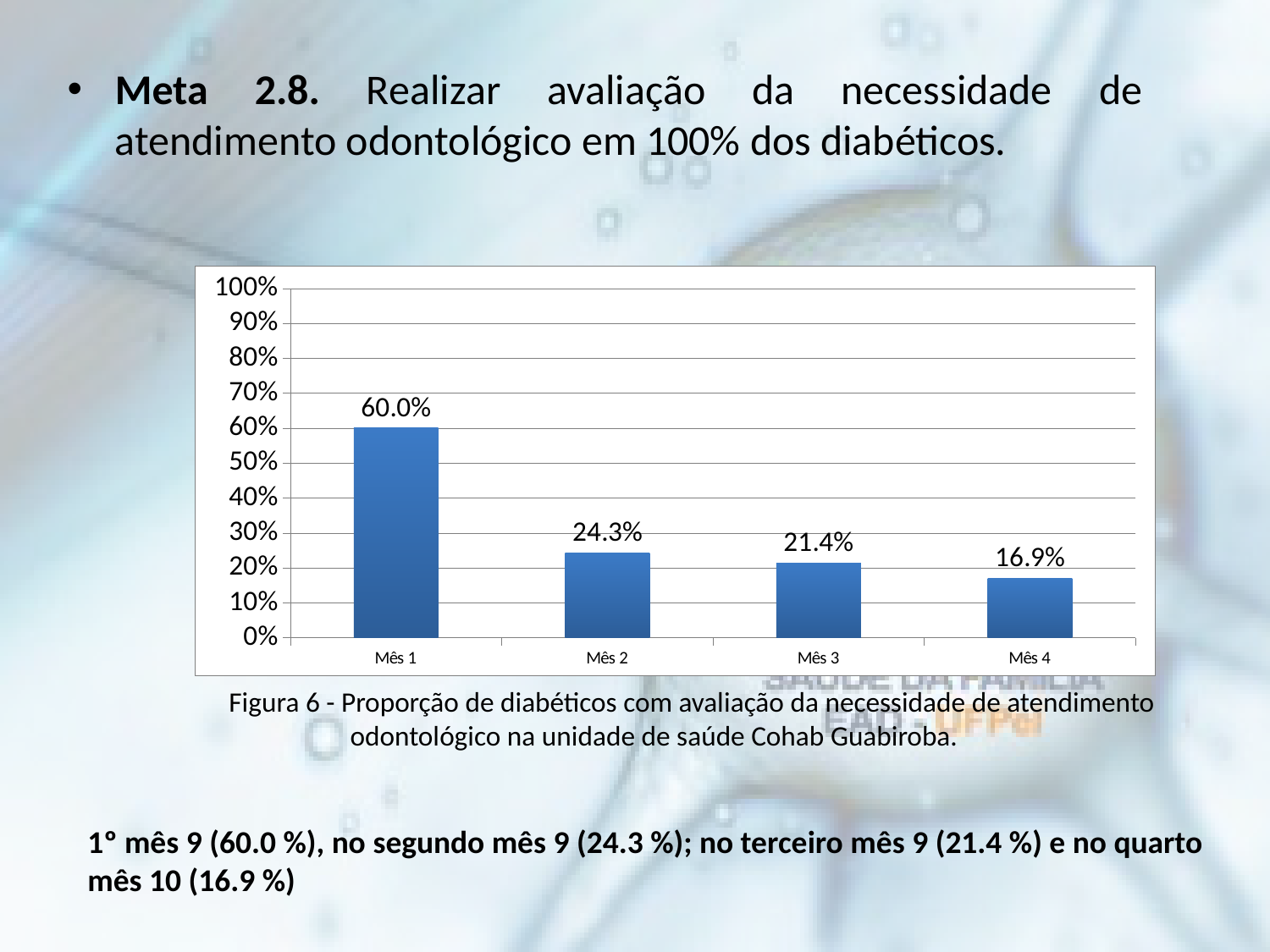
How many months are shown on the x axis? 4 Which is larger, the value for Mês 2 or the value for Mês 4? Mês 2 Which month has the lowest value? Mês 4 What is the difference between the values for Mês 1 and Mês 2? 35.7% Is the value for Mês 3 greater or less than 30%? less Which month has the highest value? Mês 1 What is the value for Mês 3? 21.4% What is the value for Mês 2? 24.3% Do the values rise or fall from Mês 1 to Mês 4? fall What kind of chart is shown on the slide? bar chart What is the value for Mês 1? 60.0% What is the value for Mês 4? 16.9%